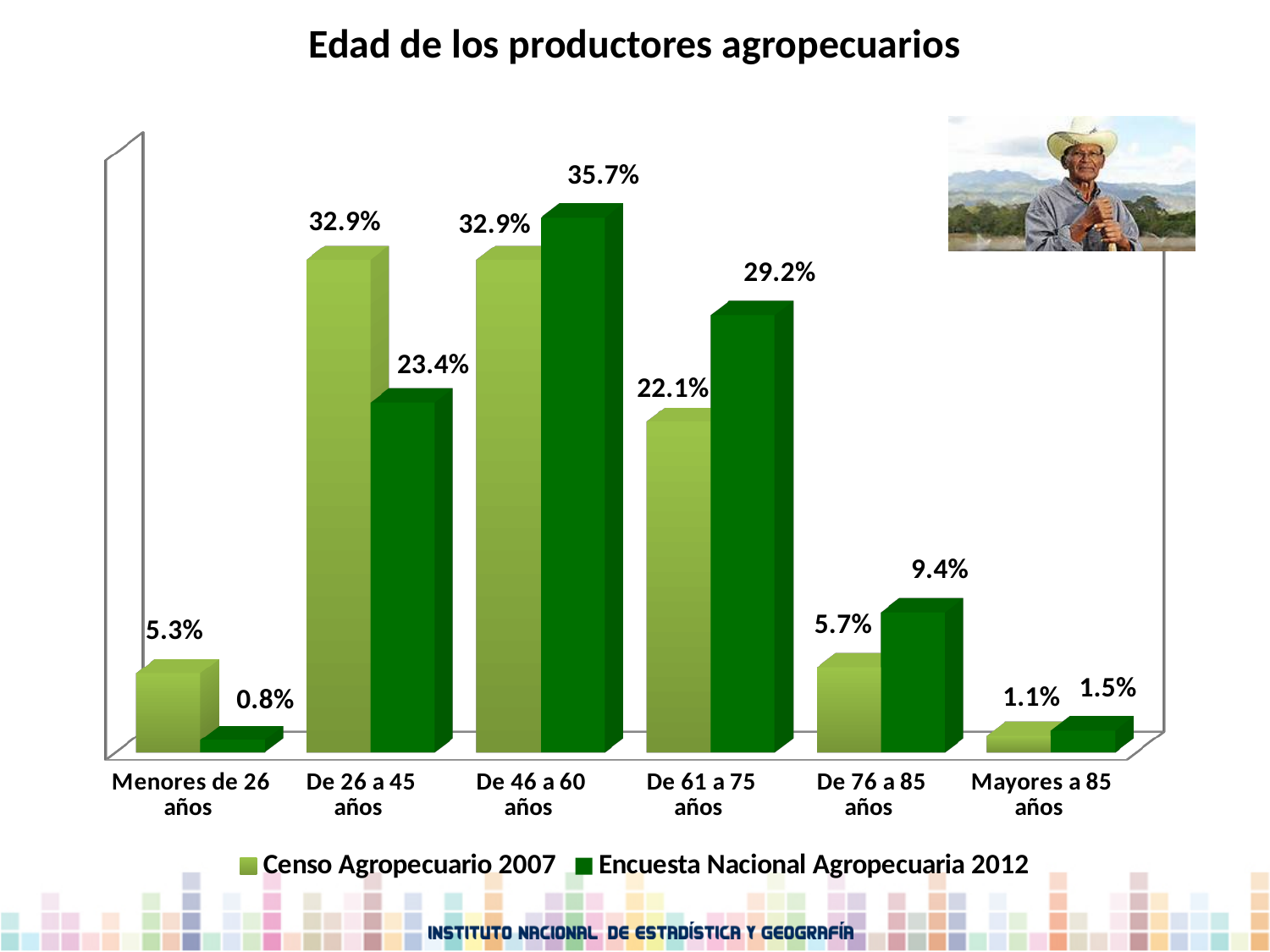
Which age group has the lowest value in the Encuesta Nacional Agropecuaria 2012 series? Menores de 26 años For De 76 a 85 años, which series has the larger value: Censo Agropecuario 2007 or Encuesta Nacional Agropecuaria 2012? Encuesta Nacional Agropecuaria 2012 What is the value for De 26 a 45 años in the Encuesta Nacional Agropecuaria 2012 series? 23.4% What type of chart is shown on the slide? Bar chart What is the difference between the Censo Agropecuario 2007 and Encuesta Nacional Agropecuaria 2012 values for De 26 a 45 años? 9.5% What is the value for De 61 a 75 años in the Censo Agropecuario 2007 series? 22.1% Which age group has the highest value in the Encuesta Nacional Agropecuaria 2012 series? De 46 a 60 años Which age group has the lowest value in the Censo Agropecuario 2007 series? Mayores a 85 años How many age groups are shown on the x axis? 6 What is the difference between the Encuesta Nacional Agropecuaria 2012 and Censo Agropecuario 2007 values for De 61 a 75 años? 7.1% What is the value for Mayores a 85 años in the Encuesta Nacional Agropecuaria 2012 series? 1.5% How many series does the legend list? 2